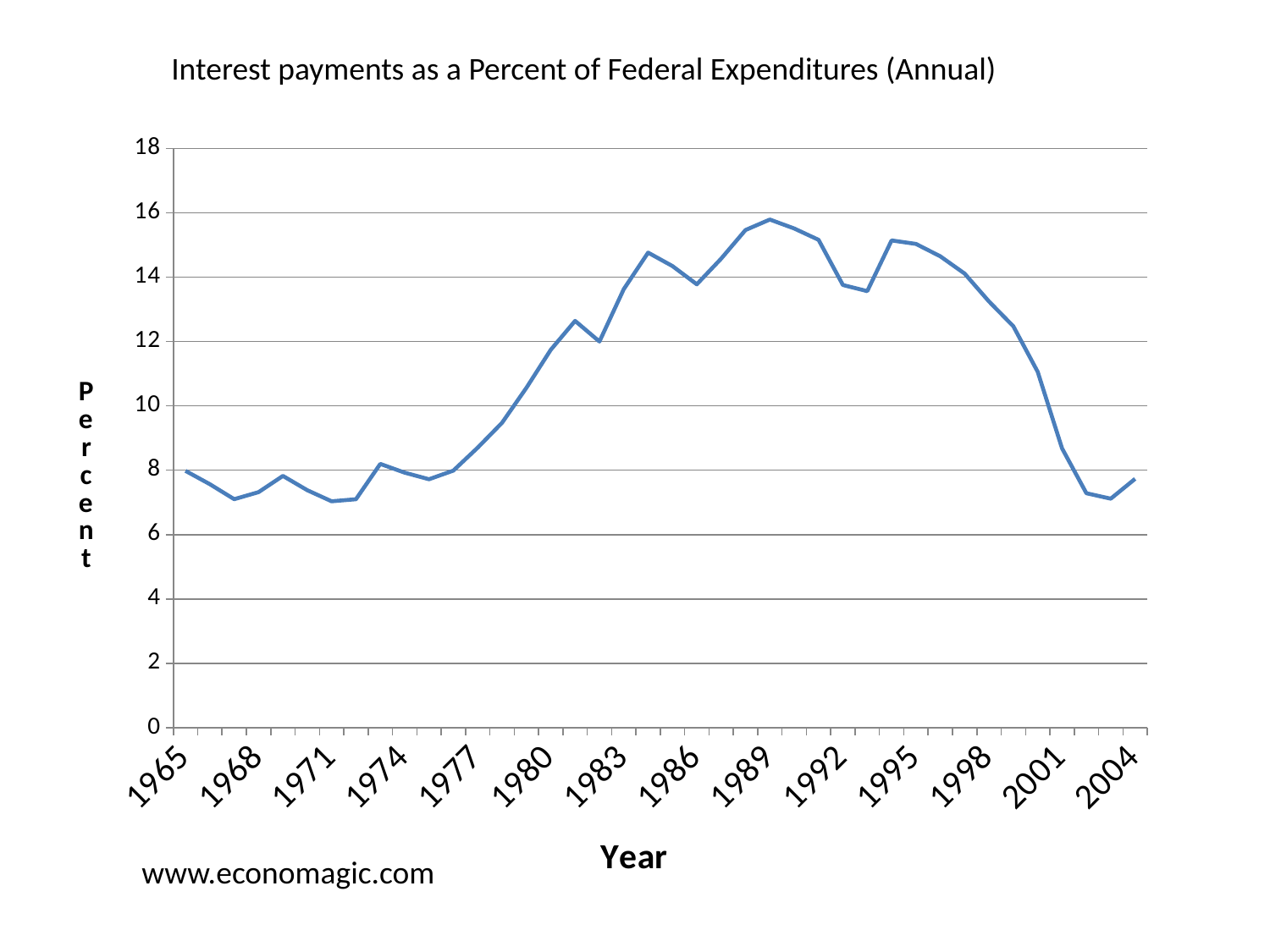
Which labeled year on the x axis has the highest value? 1989 Which is larger, the value for 1980 or the value for 2004? 1980 What is the label on the x axis of the chart? Year Is the value for 1971 greater or less than 8? less Is the value for 1980 greater or less than 10? greater Is the value for 1989 greater or less than 14? greater Do the values rise or fall between 1977 and 1989? rise What kind of chart is shown on the slide? line chart What is the title of the chart? Interest payments as a Percent of Federal Expenditures (Annual)